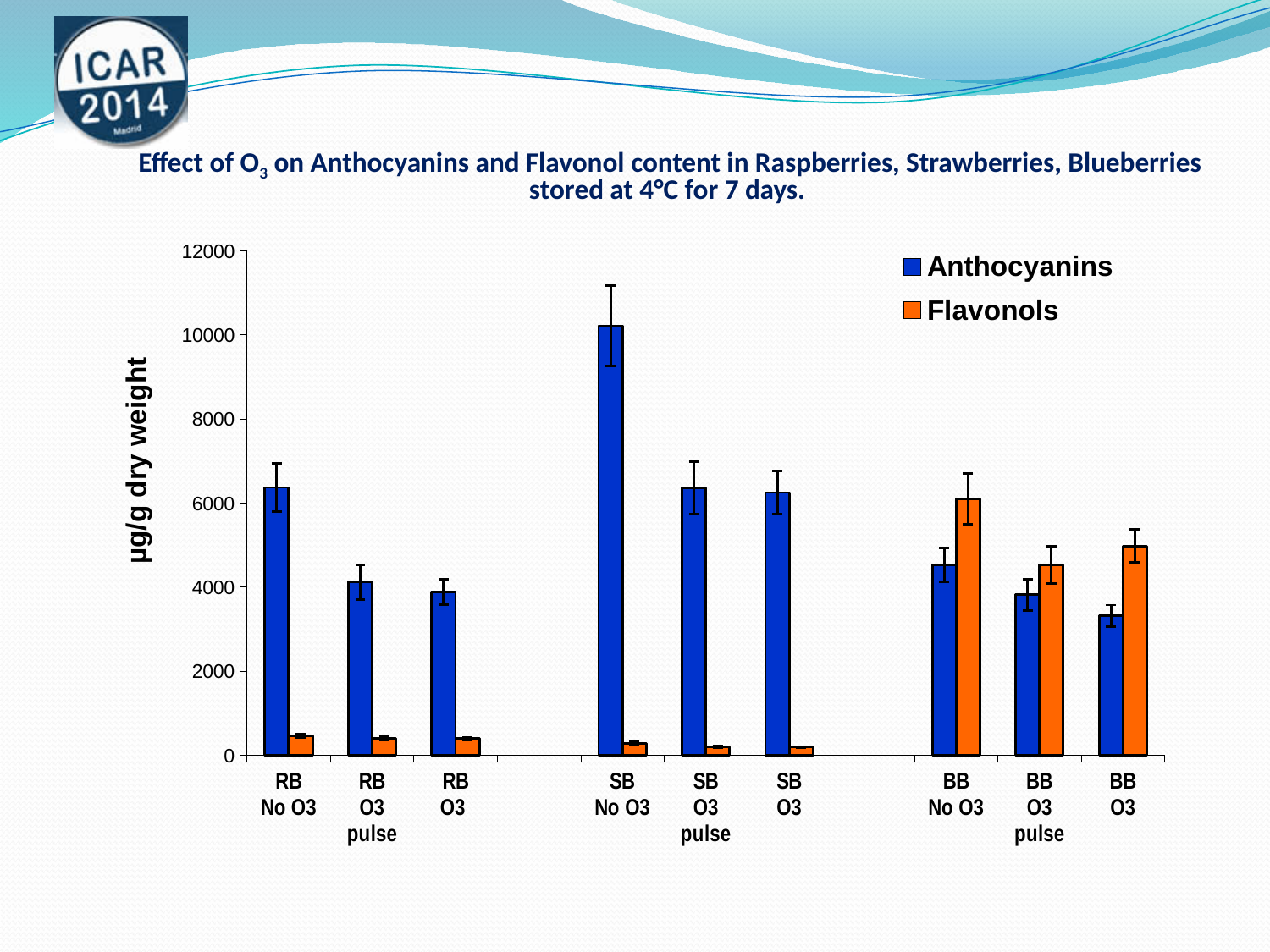
Is the Anthocyanins value for SB No O3 greater or less than 8000? greater Which category has the lowest Anthocyanins value? BB O3 How many series does the legend list? 2 Is the Anthocyanins value for BB O3 greater or less than 4000? less Which category has the highest Flavonols value? BB No O3 Is the Flavonols value for BB No O3 greater or less than 4000? greater What kind of chart is shown on the slide? bar chart Which category has the highest Anthocyanins value? SB No O3 How many categories are shown along the x axis? 9 What is the label of the y axis? µg/g dry weight Which has the larger Anthocyanins value: RB No O3 or SB No O3? SB No O3 For BB No O3, which is larger: Anthocyanins or Flavonols? Flavonols